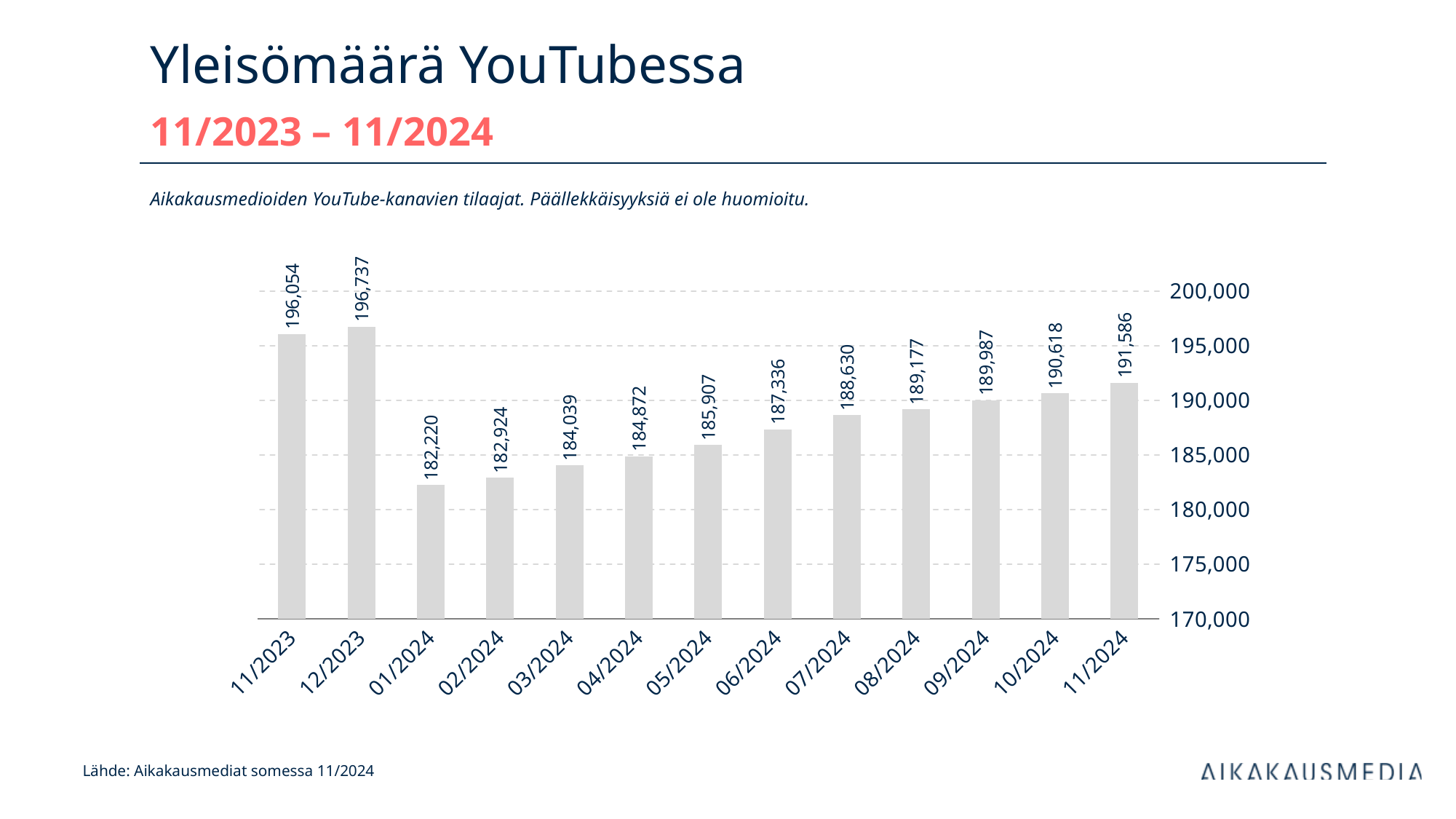
Is the value for 03/2024 greater or less than 185,000? less What kind of chart is shown on the slide? bar chart What is the value for 11/2024? 191,586 Which month has the lowest value? 01/2024 What is the value for 11/2023? 196,054 What is the value for 01/2024? 182,220 What is the difference between the values for 12/2023 and 01/2024? 14,517 What is the value for 06/2024? 187,336 Which month has the highest value? 12/2023 Which is larger, the value for 11/2023 or the value for 11/2024? 11/2023 Do the values rise or fall from 01/2024 to 11/2024? rise How many months are shown on the x axis? 13